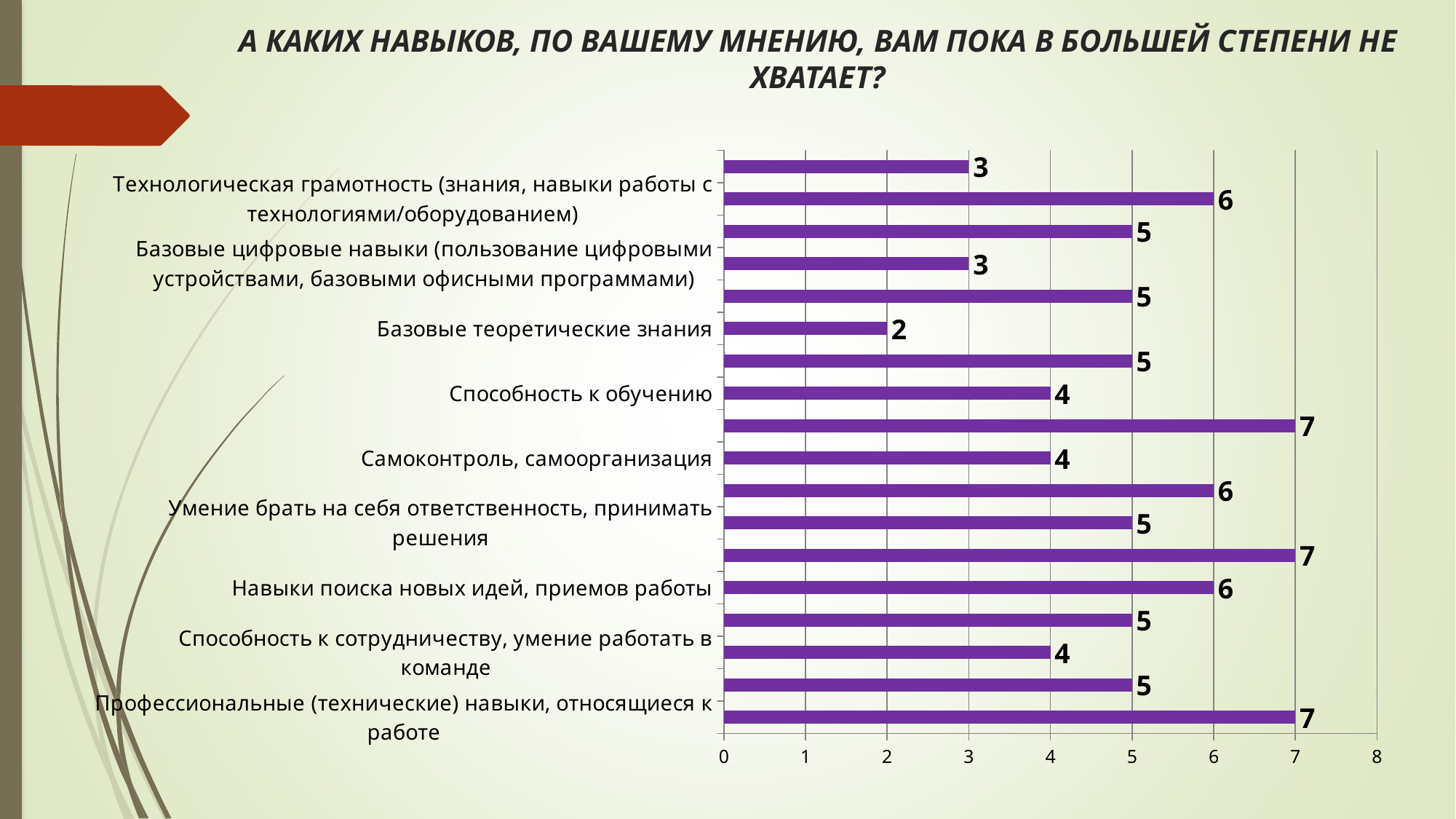
What is the maximum value shown on the horizontal axis? 8 Which is larger: the value for 'Навыки поиска новых идей, приемов работы' or the value for 'Способность к сотрудничеству, умение работать в команде'? Навыки поиска новых идей, приемов работы What is the value of the bar for 'Профессиональные (технические) навыки, относящиеся к работе'? 7 How many bars are plotted in the chart? 18 What is the value of the bar for 'Самоконтроль, самоорганизация'? 4 What type of chart is shown on the slide? bar chart What is the difference between the values for 'Профессиональные (технические) навыки, относящиеся к работе' and 'Базовые теоретические знания'? 5 What is the value of the bar for 'Навыки поиска новых идей, приемов работы'? 6 Which labeled category has the lowest value in the chart? Базовые теоретические знания What is the value of the bar for 'Базовые теоретические знания'? 2 What is the value of the bar for 'Способность к обучению'? 4 What is the highest value shown by any bar in the chart? 7